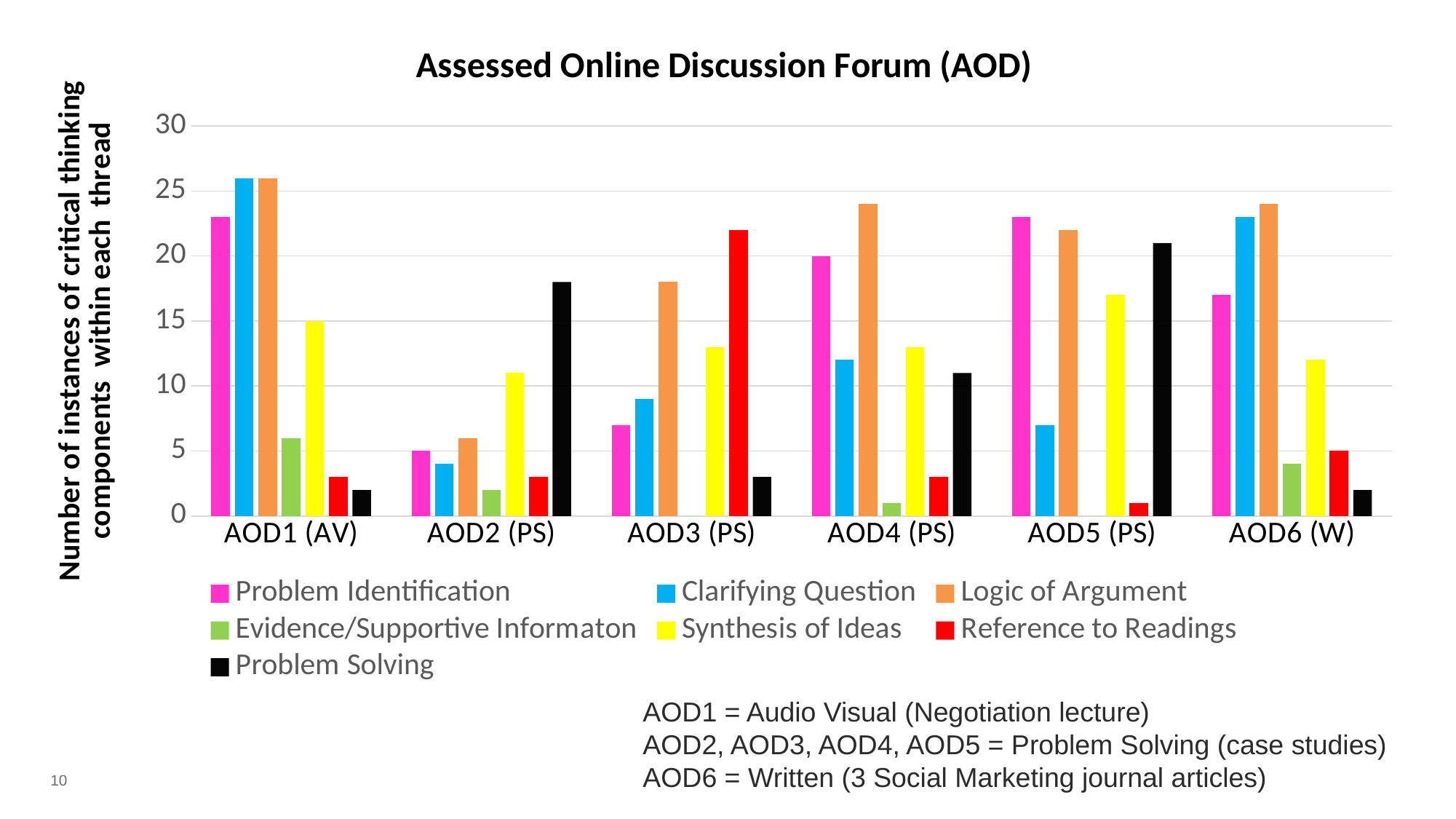
How many series does the legend list? 7 What type of chart is shown on the slide? bar chart Is the value for Clarifying Question in AOD2 (PS) greater or less than 5? less For AOD3 (PS), which is larger: Reference to Readings or Problem Solving? Reference to Readings Which series has the lowest value for AOD4 (PS)? Evidence/Supportive Informaton How many AOD categories are shown on the x axis? 6 Which series has the highest value for AOD4 (PS)? Logic of Argument Which series is shown in black in the legend? Problem Solving Is the value for Problem Solving in AOD5 (PS) greater or less than 20? greater Which series has the highest value for AOD2 (PS)? Problem Solving What is the title of the chart? Assessed Online Discussion Forum (AOD) Which series has the highest value for AOD3 (PS)? Reference to Readings